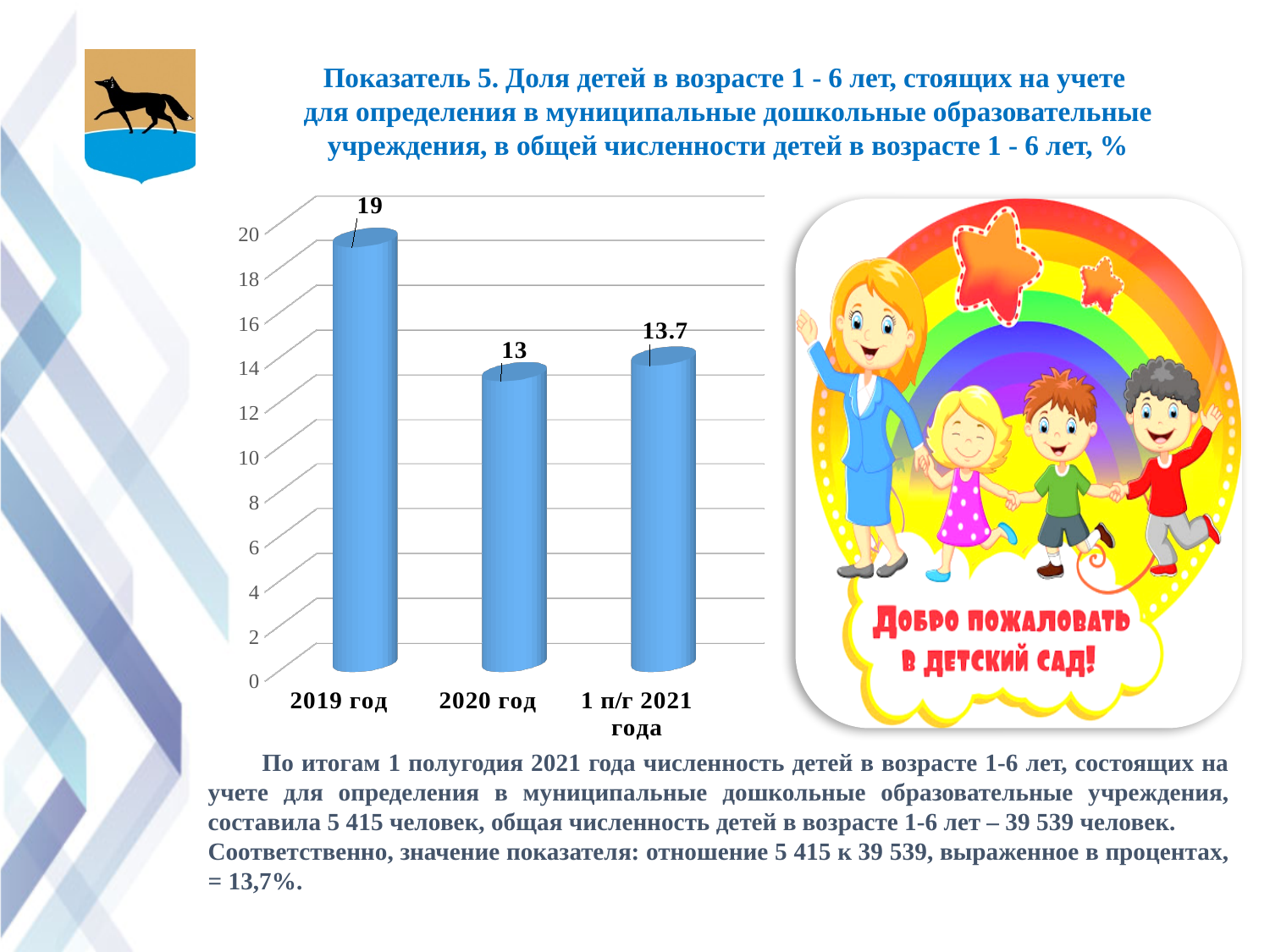
Which category has the highest value? 2019 год What is the value for 1 п/г 2021 года? 13.7 Does the value rise or fall from 2019 год to 2020 год? fall What is the value for 2019 год? 19 Which category has the lowest value? 2020 год What is the difference between the values for 1 п/г 2021 года and 2020 год? 0.7 How many categories are shown on the x axis? 3 What is the value for 2020 год? 13 Which is larger, the value for 2019 год or the value for 1 п/г 2021 года? 2019 год Is the value for 2020 год greater or less than 14? less What is the difference between the values for 2019 год and 2020 год? 6 What kind of chart is shown on the slide? bar chart